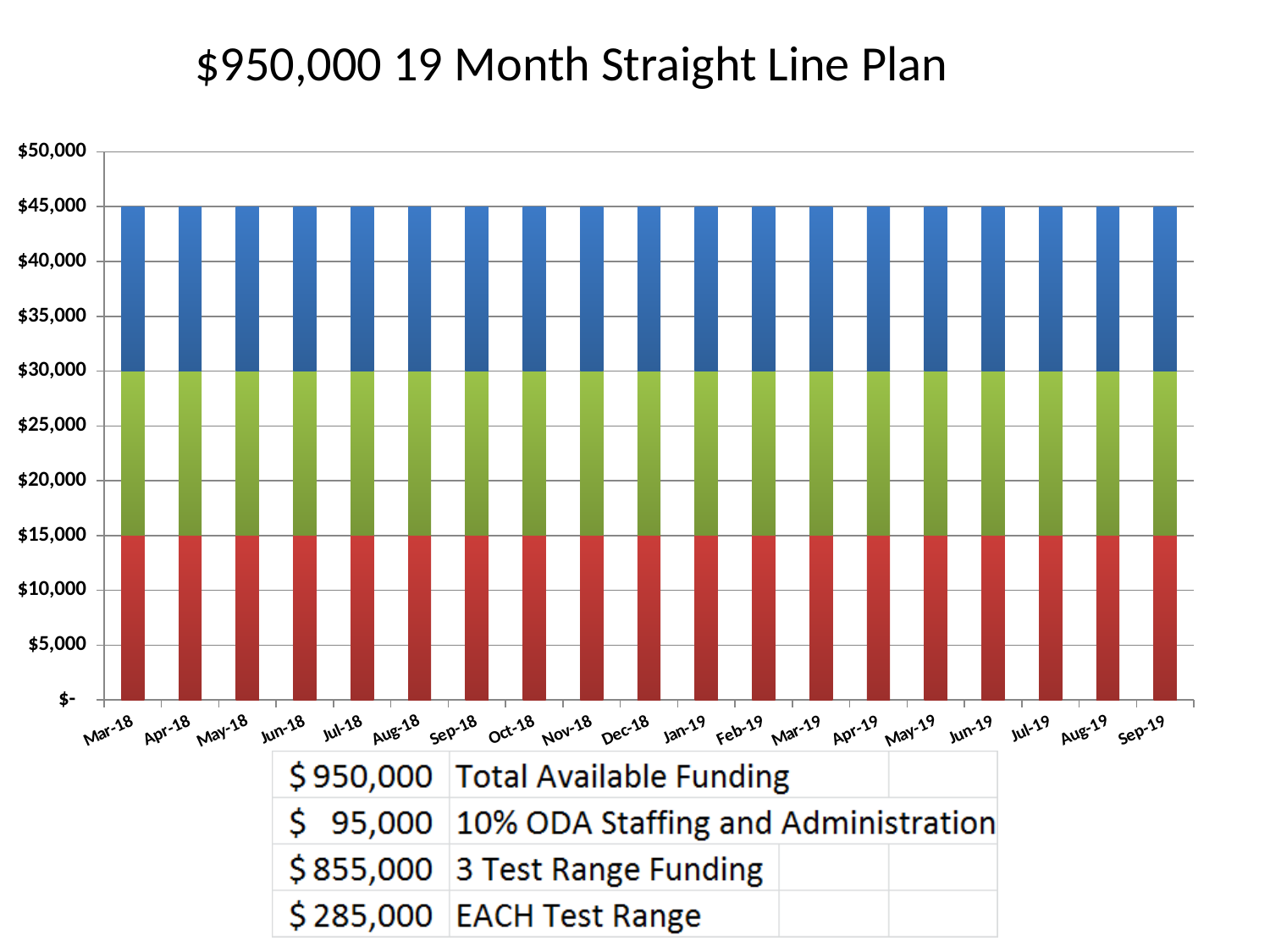
What kind of chart is shown on the slide? Stacked bar chart Is the total value for Dec-18 greater or less than $40,000? greater How many months are plotted along the x axis of the chart? 19 Is the red segment of the Apr-19 bar greater or less than $20,000? less What is the total height of the stacked bar for Sep-19? $45,000 What is the title of the chart? $950,000 19 Month Straight Line Plan What is the value of the bottom (red) segment of the bar for Jun-18? $15,000 What is the first month shown on the x axis? Mar-18 What is the total height of the stacked bar for Mar-18? $45,000 How many coloured segments make up each stacked bar? 3 Do the bar totals rise, fall, or stay flat from Mar-18 to Sep-19? Stay flat What is the highest value shown on the y axis? $50,000